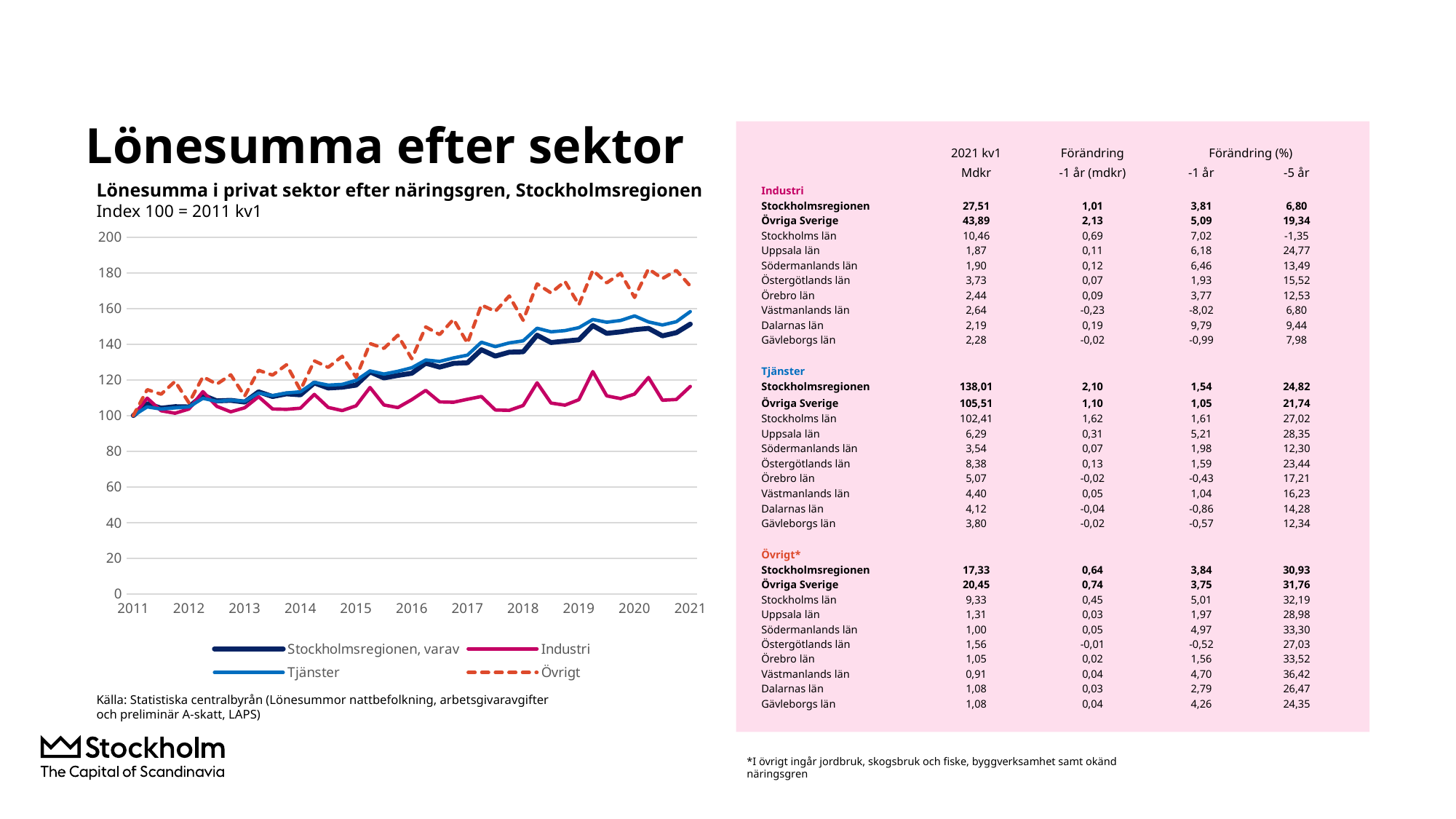
Is the value for Övrigt in 2021 greater or less than 160? greater Which series has the lowest value at the end of the chart in 2021? Industri Does the Tjänster series rise or fall overall from 2011 to 2021? Rise Which series has the highest value at the end of the chart in 2021? Övrigt Is the value for Tjänster in 2021 greater or less than 140? greater How many year labels are shown on the x axis of the chart? 11 In 2021, which series has the larger value, Tjänster or Industri? Tjänster Which series is drawn with a dashed line in the chart? Övrigt How many series does the chart's legend list? 4 What is the subtitle of the chart above the plot area? Lönesumma i privat sektor efter näringsgren, Stockholmsregionen Is the value for Industri in 2021 greater or less than 140? less What kind of chart is shown on the slide? Line chart